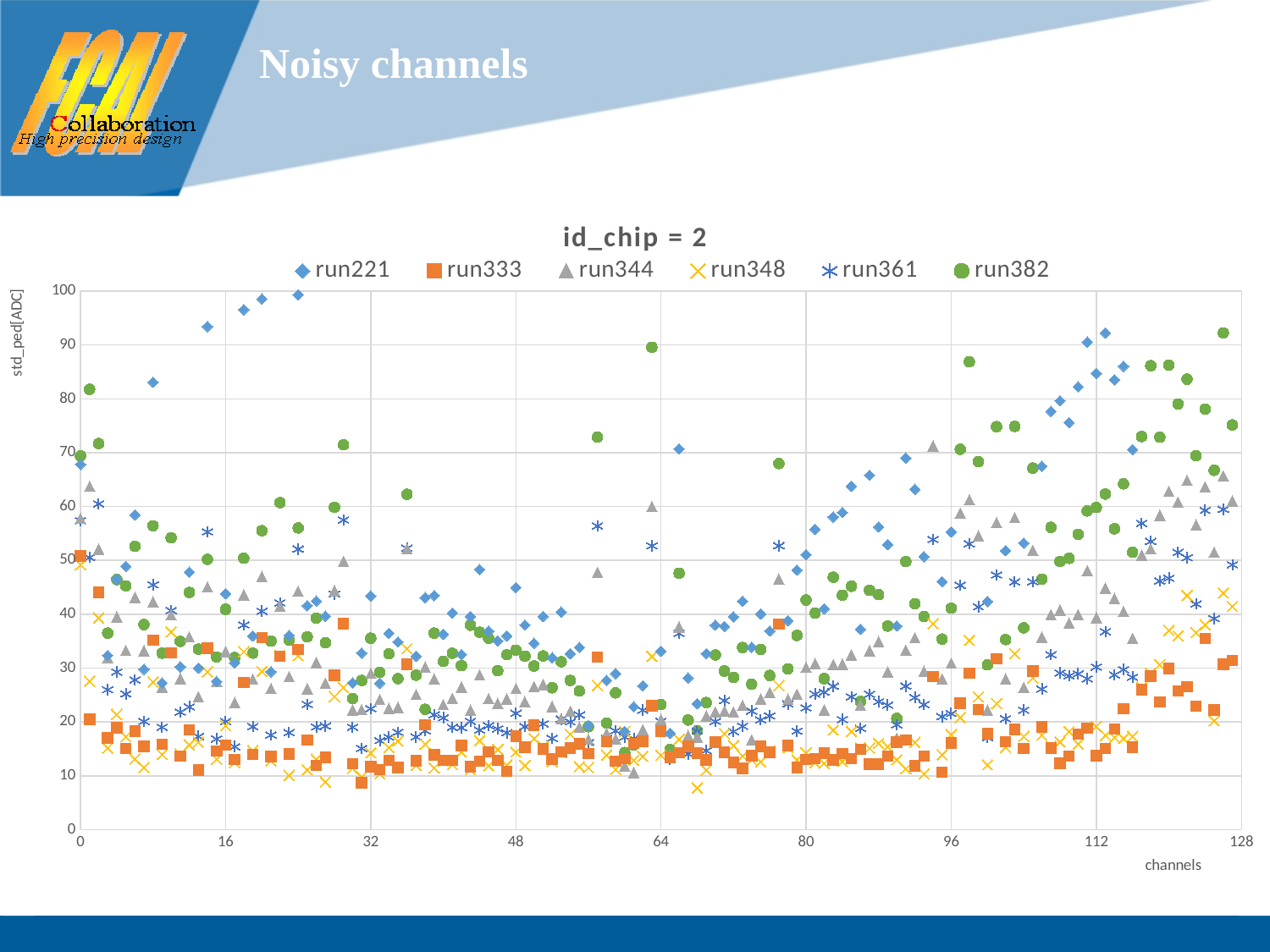
Which series is plotted with green circle markers? run382 What is the title of the chart? id_chip = 2 What is the highest value shown on the y axis? 100 What is the label of the x axis? channels What kind of chart is shown on the slide? scatter chart Is the value for run221 at channel 24 greater or less than 90? greater What is the highest value shown on the x axis? 128 What is the label of the y axis? std_ped[ADC] Is the value for run333 at channel 31 greater or less than 20? less Is the value for run382 at channel 63 greater or less than 80? greater How many series does the legend list? 6